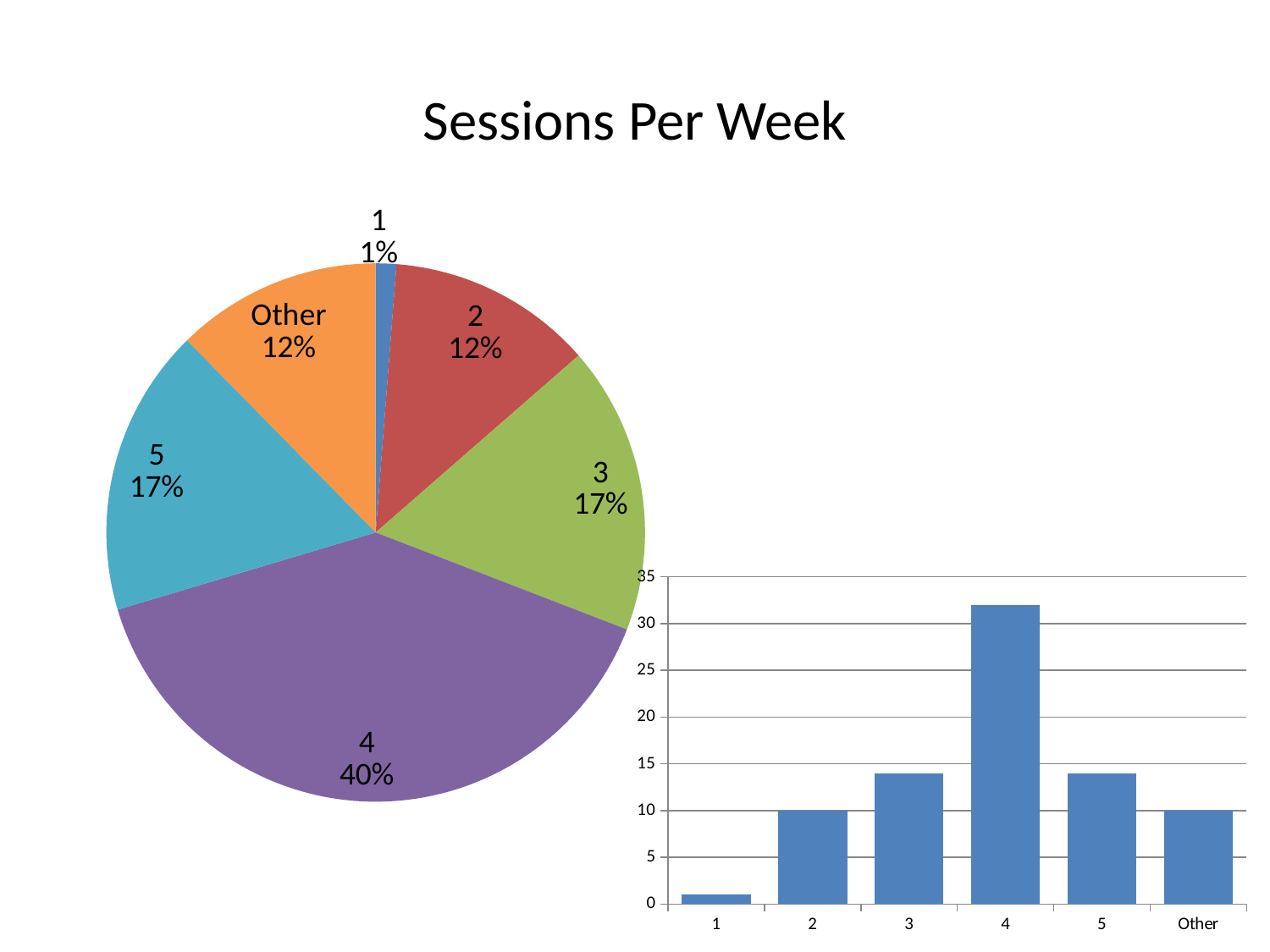
What type of chart is on the right side of the slide? bar chart In the pie chart on the left, which is larger, the slice for category 2 or the slice for category 5? 5 In the pie chart on the left, what is the difference in percentage points between category 4 and category 3? 23 In the bar chart on the right, what is the value for category 2? 10 In the bar chart on the right, is the value for category 4 greater or less than 30? greater How many slices does the pie chart on the left have? 6 What is the title of the slide? Sessions Per Week In the pie chart on the left, what percentage is shown for category 1? 1% In the bar chart on the right, is the value for category 3 greater or less than 15? less In the pie chart on the left, which category has the largest slice? 4 In the pie chart on the left, what share does category 4 have? 40% In the pie chart on the left, which category has the smallest slice? 1